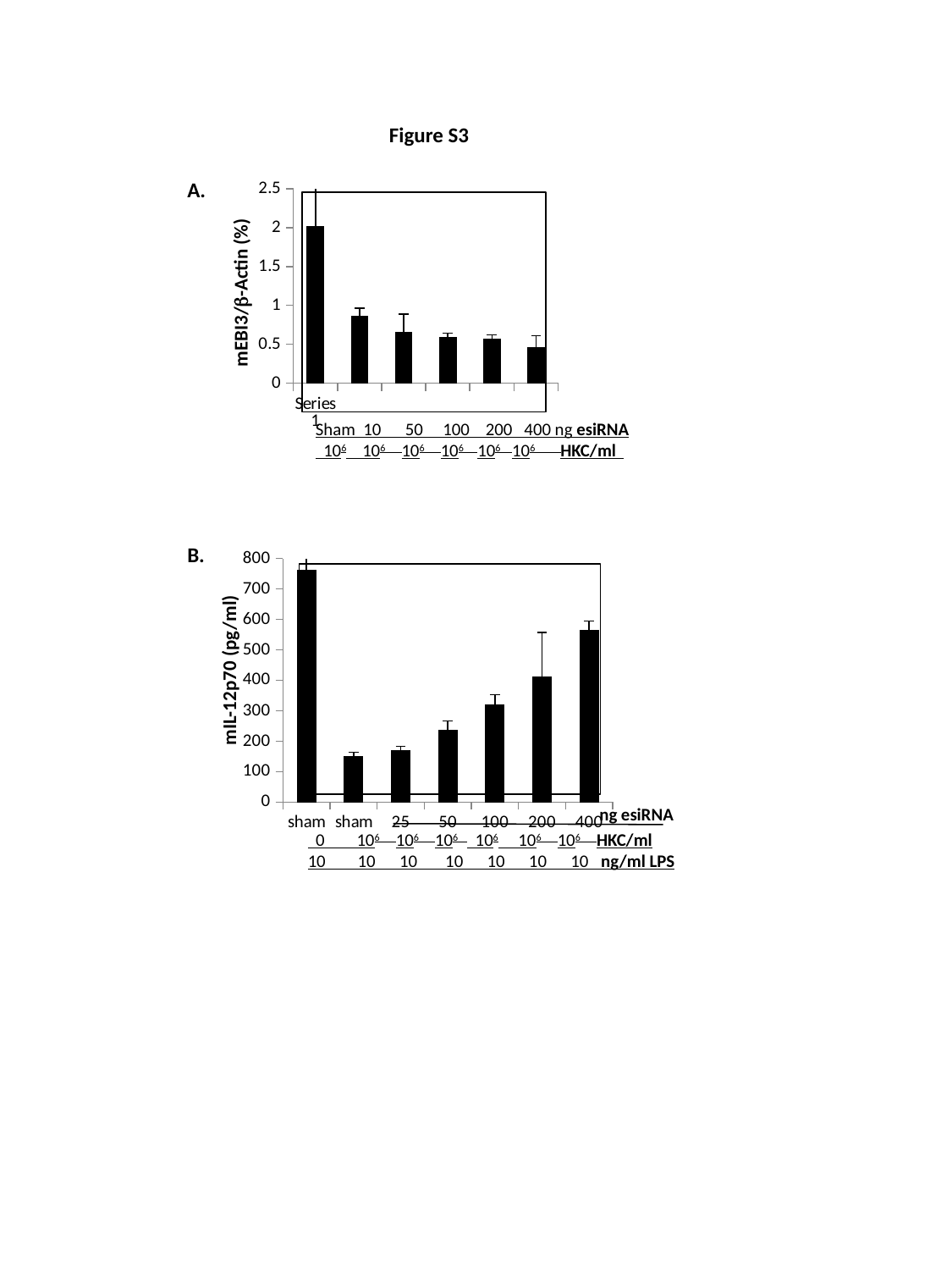
In chart B, which bar has the highest value? sham with 0 HKC/ml In chart B, which is larger, the value for 200 ng esiRNA or 400 ng esiRNA? 400 ng esiRNA In chart A, do the values rise or fall as the esiRNA dose increases from Sham to 400 ng? fall What is the y-axis label of chart B? mIL-12p70 (pg/ml) In chart A, which category has the lowest value? 400 ng esiRNA In chart A, which category has the highest value? Sham In chart A, how many bars are plotted? 6 In chart B, how many bars are plotted? 7 In chart A, is the value for Sham greater or less than 1.5? greater In chart B, is the value for 400 ng esiRNA greater or less than 500? greater What kind of chart is chart A? bar chart In chart A, is the value for 10 ng esiRNA greater or less than 1? less